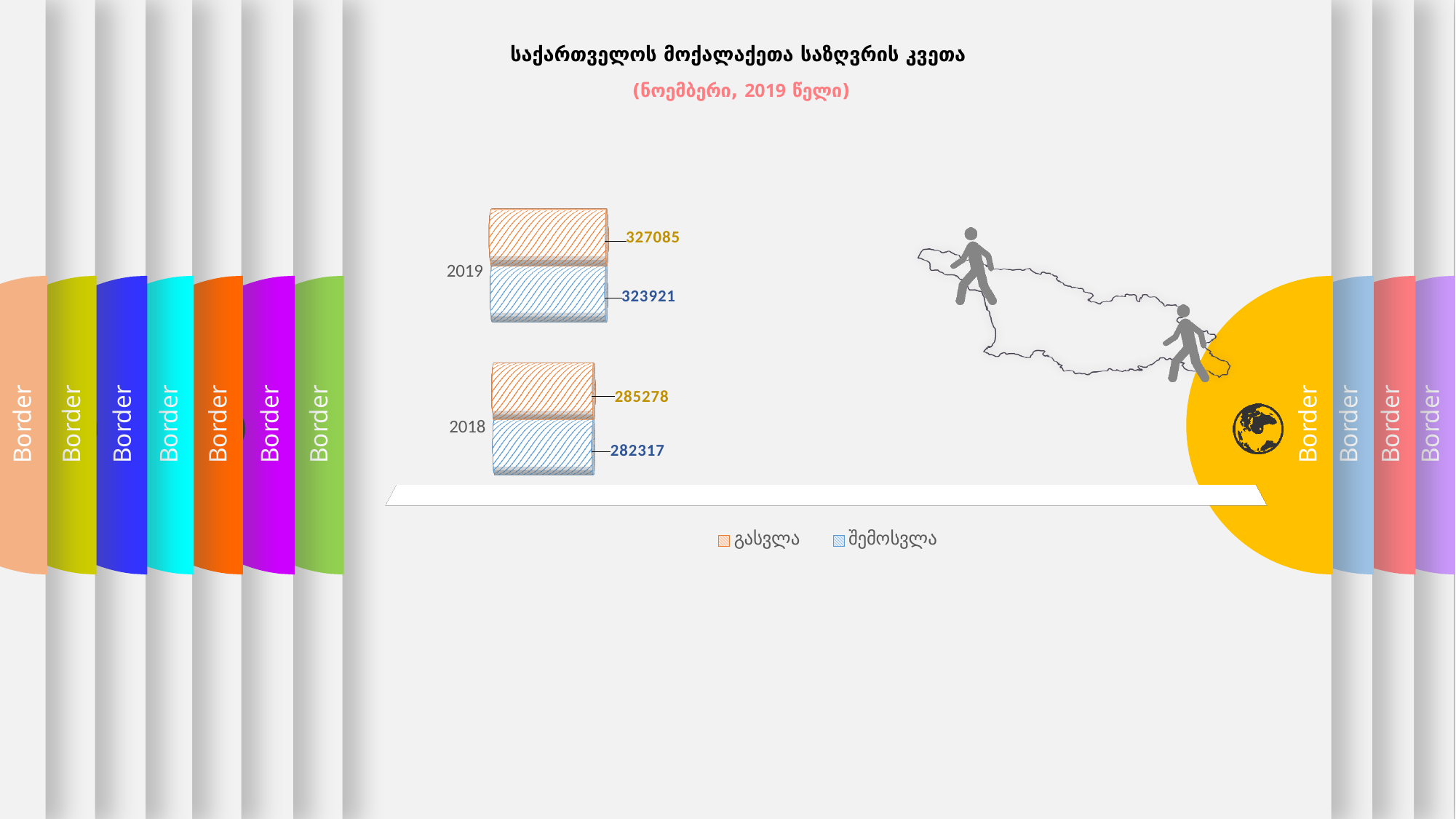
What kind of chart is shown on the slide? Bar chart What is the difference between გასვლა and შემოსვლა in 2018? 2961 Which year has the higher value for გასვლა? 2019 What is the value of გასვლა for 2018? 285278 How many years are shown on the chart? 2 How many series does the legend list? 2 What is the value of შემოსვლა for 2019? 323921 What is the value of შემოსვლა for 2018? 282317 What is the difference between გასვლა in 2019 and გასვლა in 2018? 41807 Which is larger in 2019, გასვლა or შემოსვლა? გასვლა Which year has the lower value for შემოსვლა? 2018 What is the value of გასვლა for 2019? 327085